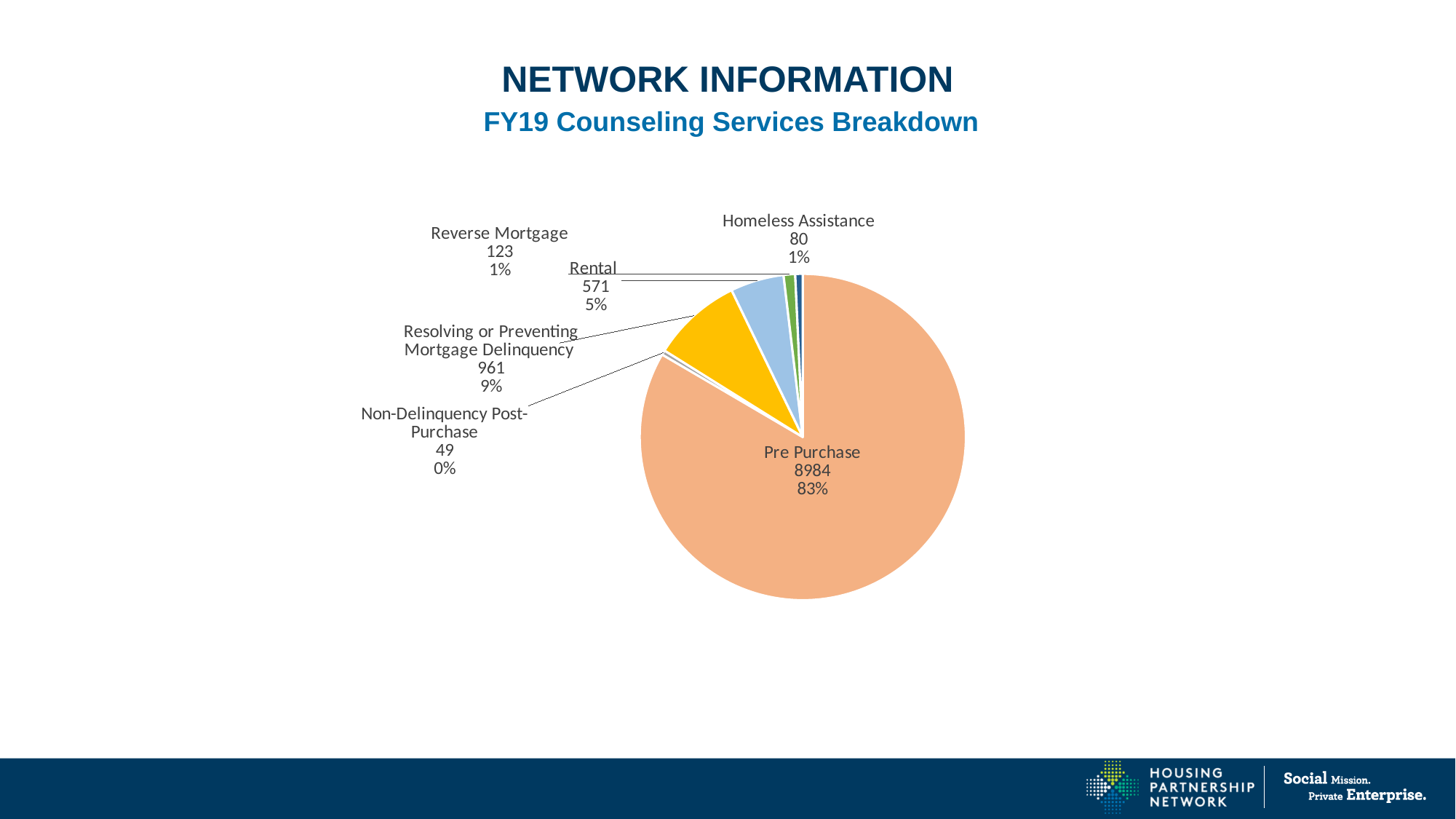
What is the value for Rental? 571 What is the value for Resolving or Preventing Mortgage Delinquency? 961 What share of the pie does Rental represent? 5% Which counseling service has the largest slice? Pre Purchase What share of the pie does Pre Purchase represent? 83% Which is larger, the value for Reverse Mortgage or the value for Homeless Assistance? Reverse Mortgage What is the value for Pre Purchase? 8984 How many counseling services are shown in the pie chart? 6 What is the value for Homeless Assistance? 80 What is the difference between the values for Resolving or Preventing Mortgage Delinquency and Rental? 390 Which counseling service has the smallest slice? Non-Delinquency Post-Purchase What kind of chart is shown on the slide? pie chart